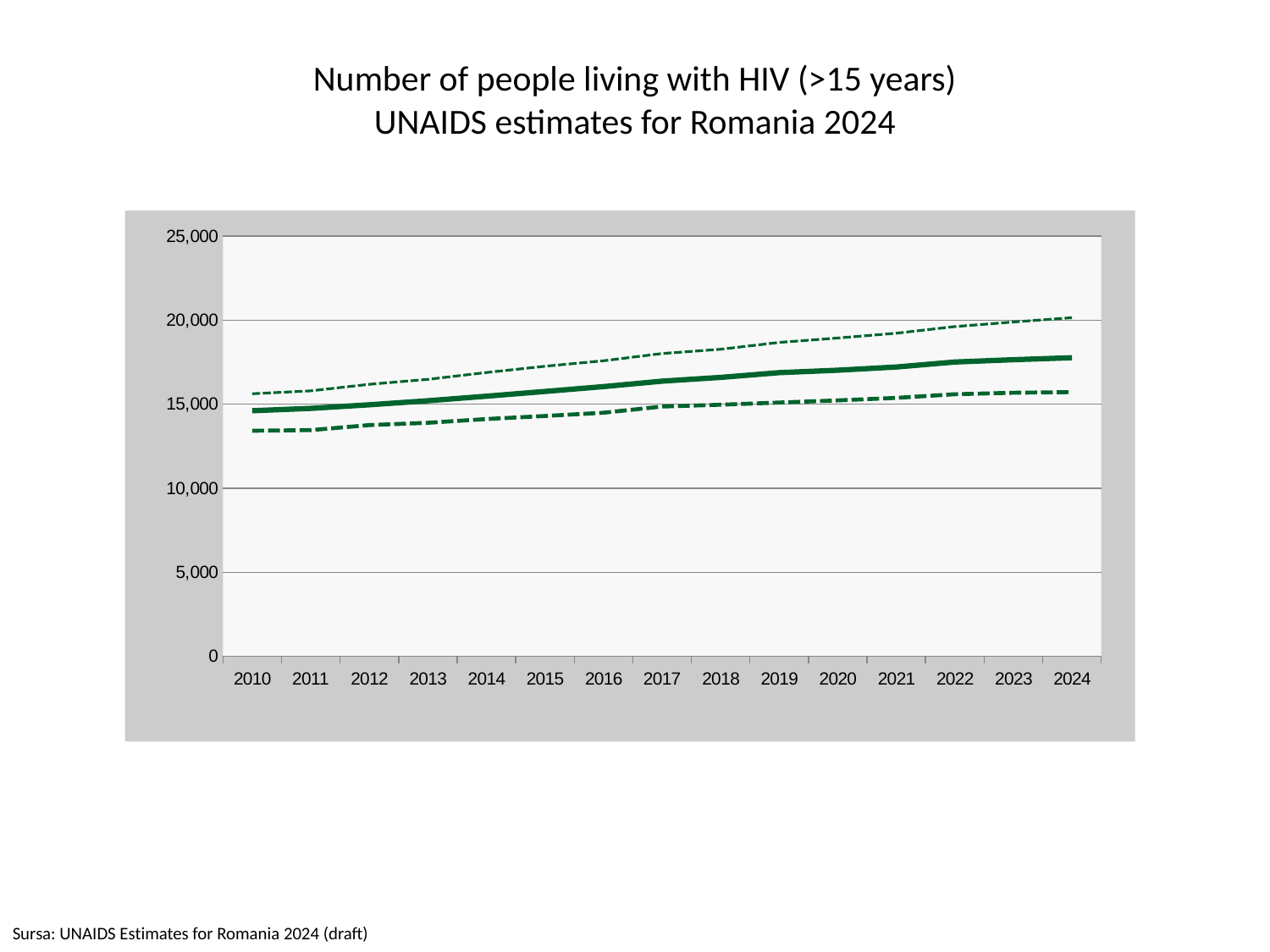
In which year does the solid line reach its highest value? 2024 Is the value of the upper dashed line in 2010 greater or less than 15,000? greater Is the value of the lower dashed line in 2010 greater or less than 15,000? less What is the last year shown on the x axis? 2024 What is the first year shown on the x axis? 2010 In which year does the solid line have its lowest value? 2010 Does the solid line rise or fall from 2010 to 2024? rise How many years are shown along the x axis of the chart? 15 Is the value of the solid line in 2010 greater or less than 15,000? less What kind of chart is shown on the slide? line chart Which is larger for the solid line: the value in 2010 or the value in 2024? 2024